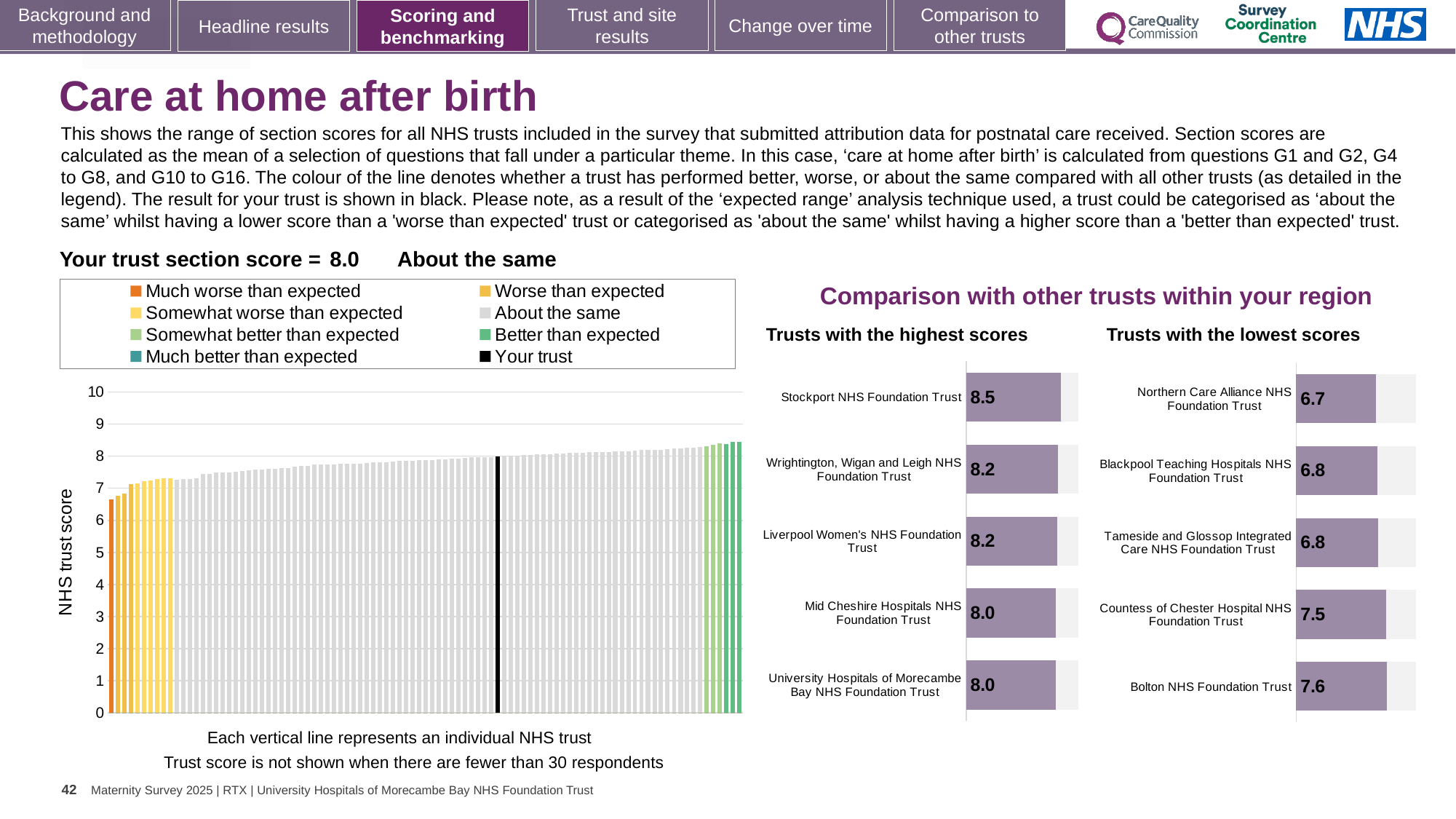
In the 'Trusts with the lowest scores' chart, which has the larger score: Countess of Chester Hospital NHS Foundation Trust or Blackpool Teaching Hospitals NHS Foundation Trust? Countess of Chester Hospital NHS Foundation Trust In the main chart on the left, do the trust scores rise or fall from left to right? Rise What type of chart is the main chart on the left showing NHS trust scores? Bar chart How many trusts are shown in the 'Trusts with the highest scores' chart? 5 In the 'Trusts with the highest scores' chart, what is the score for Stockport NHS Foundation Trust? 8.5 In the 'Trusts with the lowest scores' chart, what is the score for Northern Care Alliance NHS Foundation Trust? 6.7 In the 'Trusts with the lowest scores' chart, what is the score for Bolton NHS Foundation Trust? 7.6 What is the section score for your trust shown in the main chart on the left? 8.0 In the 'Trusts with the lowest scores' chart, which trust has the lowest score? Northern Care Alliance NHS Foundation Trust How many entries does the legend above the main chart on the left list? 8 In the 'Trusts with the highest scores' chart, what is the difference between the scores of Stockport NHS Foundation Trust and Mid Cheshire Hospitals NHS Foundation Trust? 0.5 In the 'Trusts with the highest scores' chart, which trust has the highest score? Stockport NHS Foundation Trust